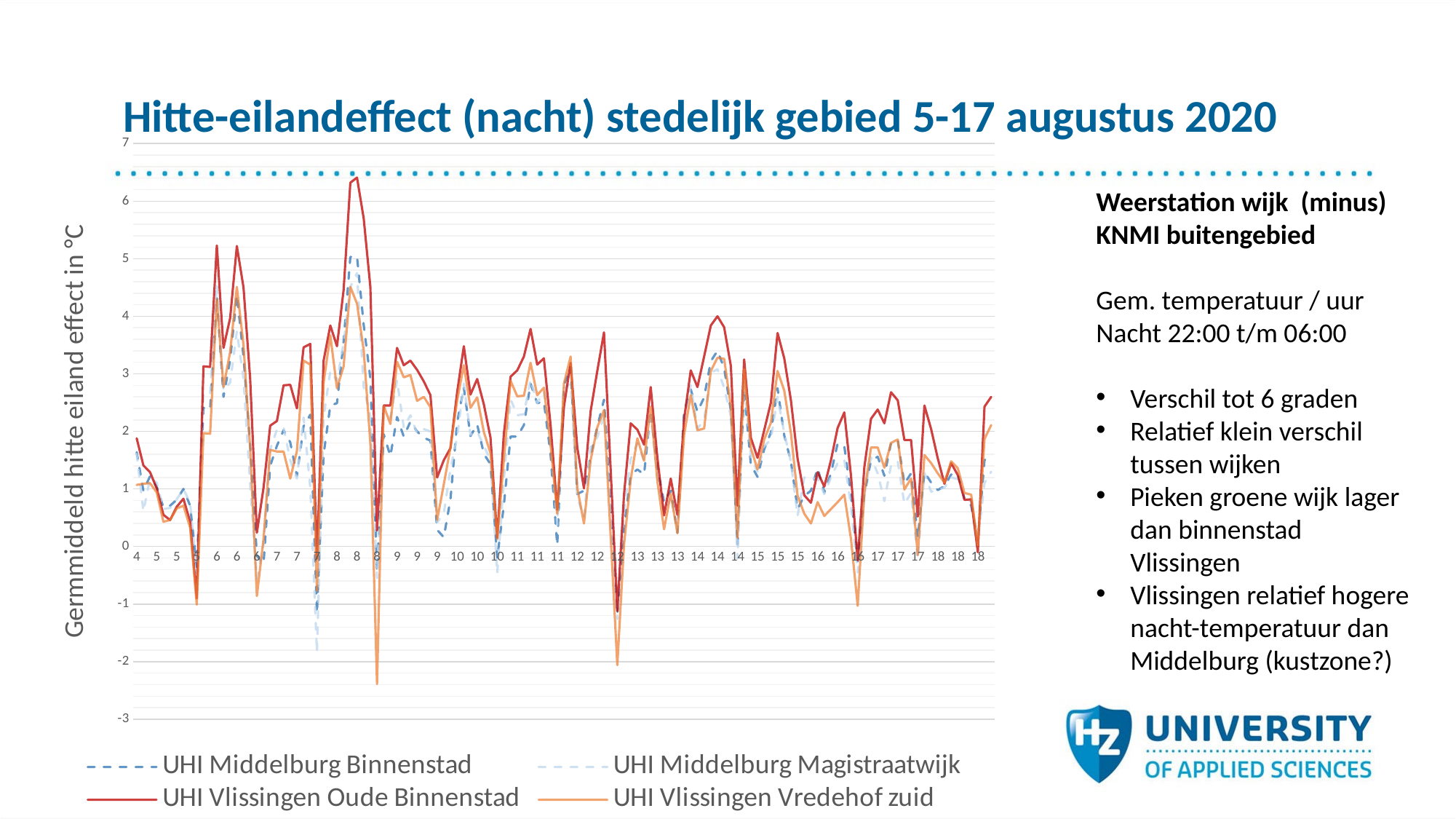
What is the label of the vertical axis? Germmiddeld hitte eiland effect in °C What kind of chart is shown on the slide? line chart What is the highest tick value shown on the vertical axis? 7 How many series does the legend list? 4 Which series has the higher peak around day 8: UHI Vlissingen Oude Binnenstad or UHI Vlissingen Vredehof zuid? UHI Vlissingen Oude Binnenstad What is the title of the chart? Hitte-eilandeffect (nacht) stedelijk gebied 5-17 augustus 2020 Is the highest peak of UHI Vlissingen Oude Binnenstad greater or less than 6? greater Which series drops to the lowest value on the chart? UHI Vlissingen Vredehof zuid Is the highest peak of UHI Middelburg Binnenstad greater or less than 4? greater Is the lowest value of UHI Vlissingen Vredehof zuid greater or less than -2? less Which series reaches the highest peak on the chart? UHI Vlissingen Oude Binnenstad